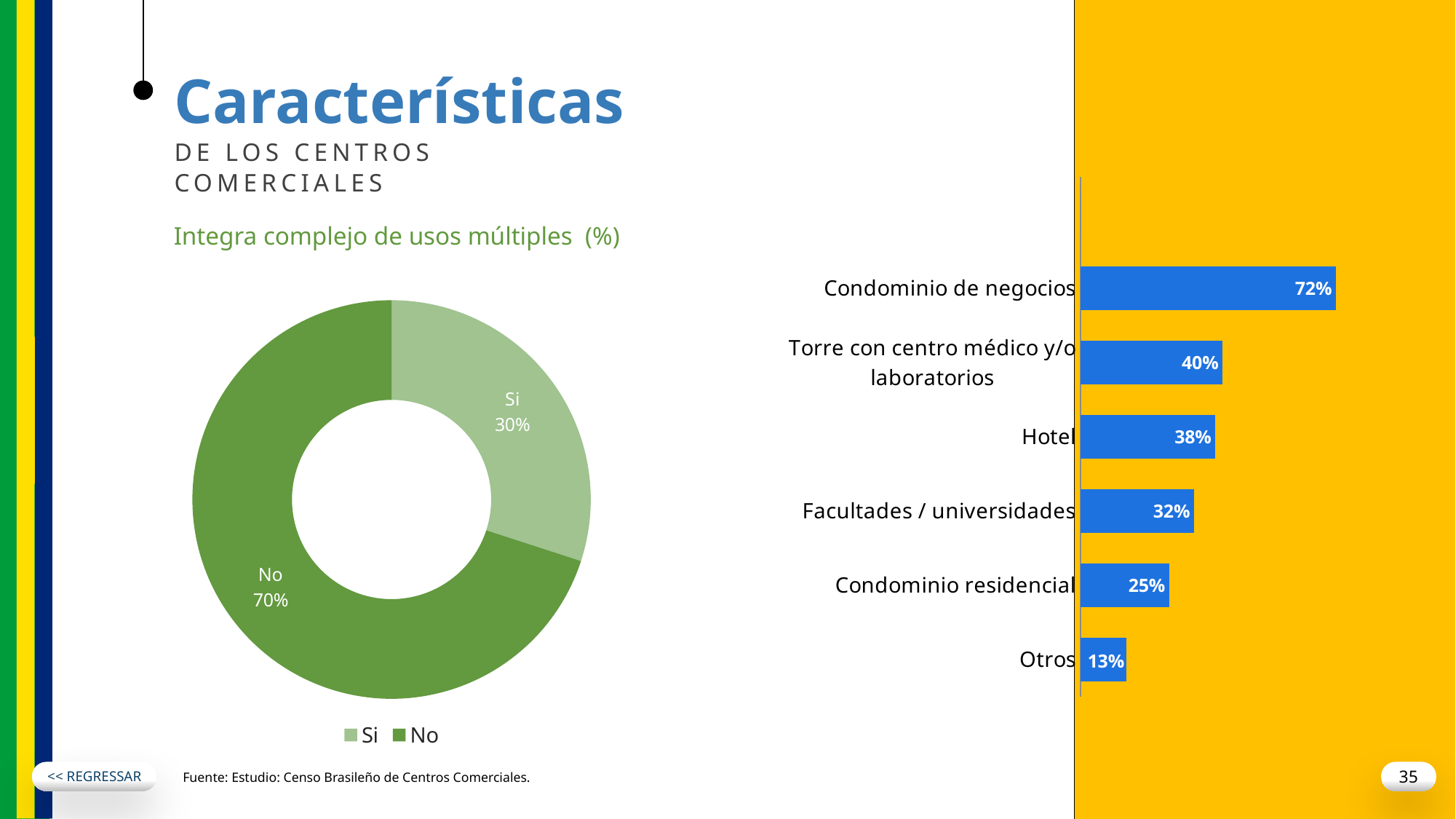
How many categories are shown in the bar chart on the right? 6 In the bar chart on the right, which category has the lowest value? Otros In the bar chart on the right, what is the value for 'Hotel'? 38% In the bar chart on the right, which category has the highest value? Condominio de negocios In the donut chart on the left, which slice is larger, 'Si' or 'No'? No In the donut chart 'Integra complejo de usos múltiples (%)', what share is labelled 'Si'? 30% In the bar chart on the right, what is the difference between 'Condominio de negocios' and 'Condominio residencial'? 47% What kind of chart is shown on the right side of the slide? Bar chart In the bar chart on the right, what is the value for 'Torre con centro médico y/o laboratorios'? 40% In the bar chart on the right, what is the value for 'Condominio de negocios'? 72% In the donut chart 'Integra complejo de usos múltiples (%)', what share is labelled 'No'? 70% How many entries does the legend of the donut chart on the left list? 2